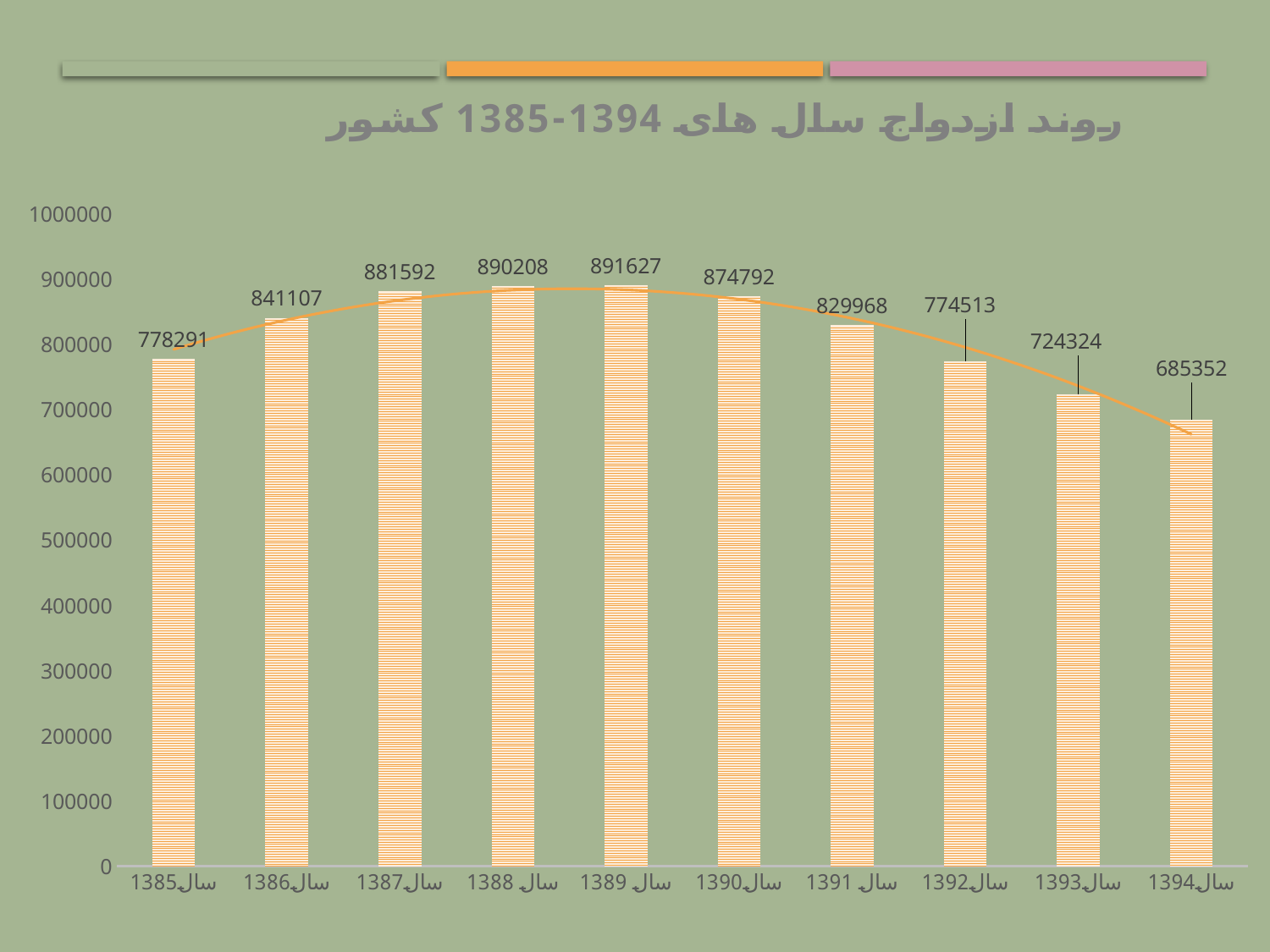
Which is larger, the value for سال 1387 or the value for سال 1391? سال 1387 What is the difference between the values for سال 1386 and سال 1385? 62816 What is the value for سال 1394? 685352 Which year has the lowest value? سال 1394 What is the value for سال 1390? 874792 What is the value for سال 1385? 778291 Which year has the highest value? سال 1389 Is the value for سال 1393 greater or less than 700000? greater How many years are shown on the x axis? 10 Do the values rise or fall from سال 1389 to سال 1394? fall What kind of chart is this? bar chart What is the difference between the values for سال 1389 and سال 1394? 206275